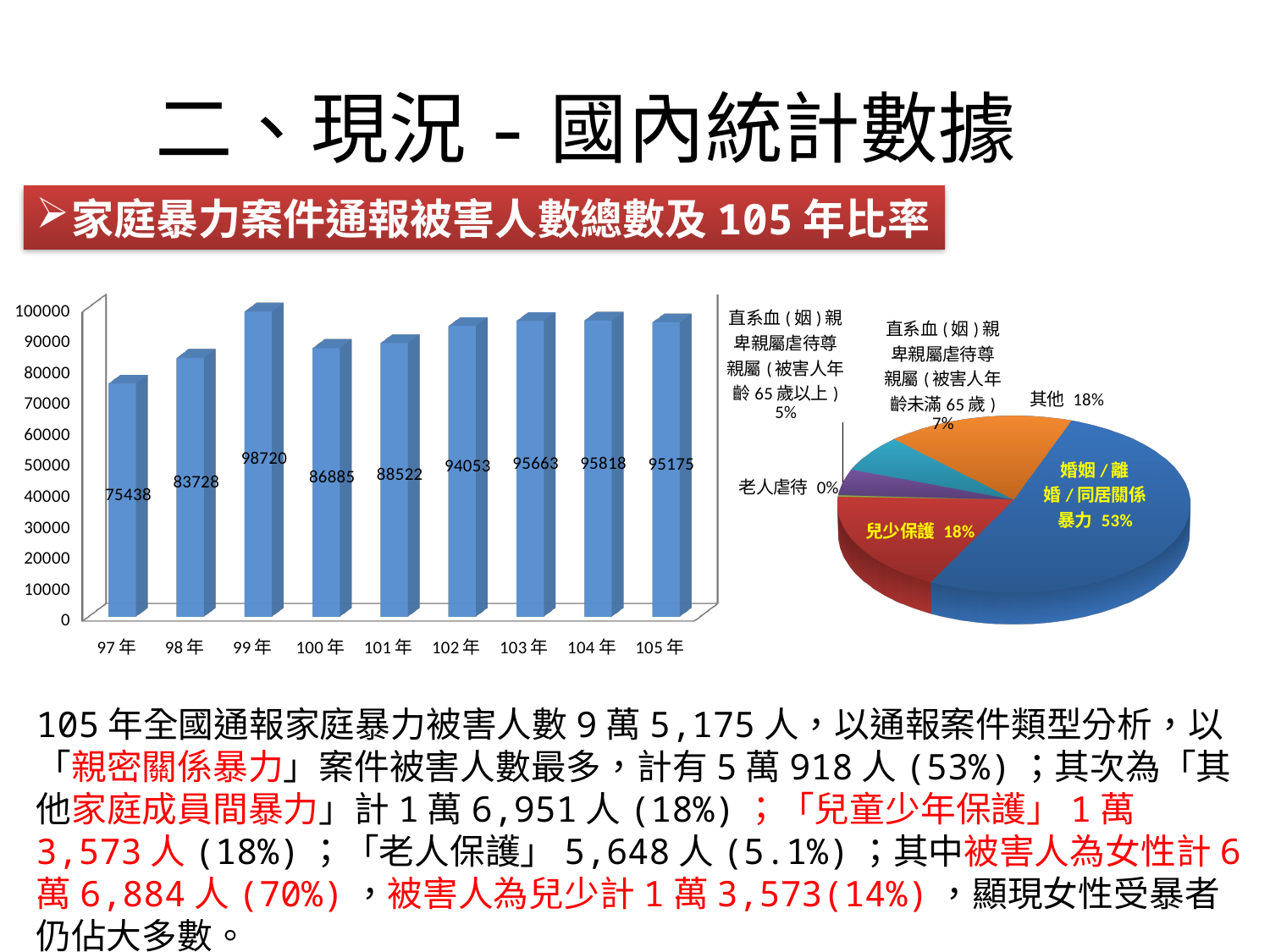
In the bar chart on the left, which year has the lowest value? 97年 In the bar chart on the left, how many years are shown on the x axis? 9 In the bar chart on the left, what is the value for 105年? 95175 In the bar chart on the left, which is larger, the value for 100年 or the value for 101年? 101年 In the pie chart on the right, what share does 婚姻/離婚/同居關係暴力 have? 53% In the bar chart on the left, what is the difference between the values for 104年 and 105年? 643 In the bar chart on the left, is the value for 98年 greater or less than 80000? greater What kind of chart is shown on the left of the slide? bar chart In the pie chart on the right, what share does 兒少保護 have? 18% In the bar chart on the left, which year has the highest value? 99年 What kind of chart is shown on the right of the slide? pie chart In the bar chart on the left, what is the value for 99年? 98720